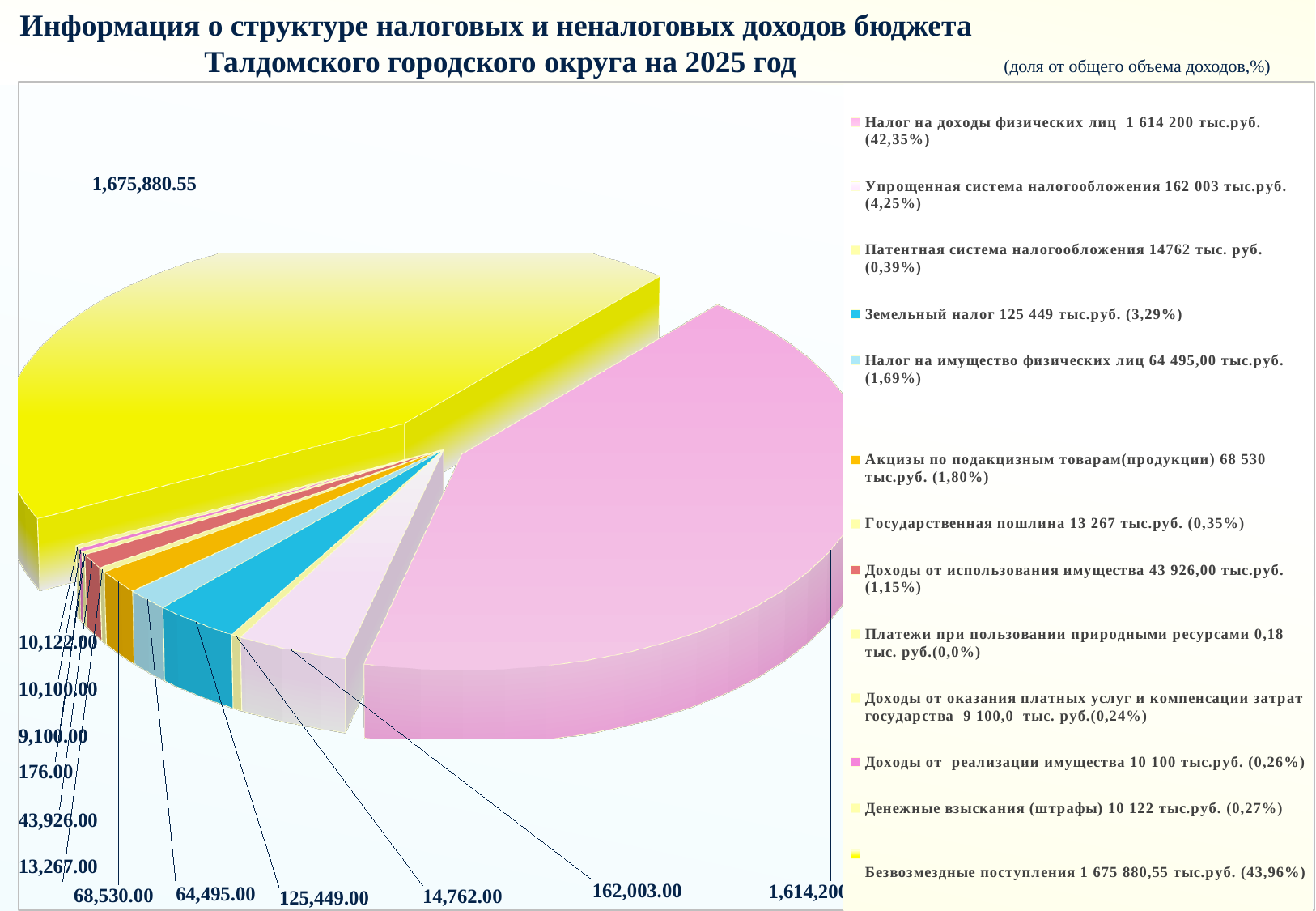
What is the data label value for the Государственная пошлина slice? 13,267.00 What is the data label value for the Безвозмездные поступления slice? 1,675,880.55 Which category has the smallest share of total revenue according to the legend? Платежи при пользовании природными ресурсами Which category has the largest share of total revenue according to the legend? Безвозмездные поступления What share of total revenue does Земельный налог account for, as shown in the legend? 3,29% What share of total revenue does Налог на доходы физических лиц account for, as shown in the legend? 42,35% What kind of chart is shown on the slide? pie chart What is the difference between the data label values for Упрощенная система налогообложения (162,003.00) and Земельный налог (125,449.00)? 36,554.00 For which year does the chart show the structure of budget revenues of Талдомский городской округ? 2025 What is the data label value for the Земельный налог slice? 125,449.00 How many categories does the legend of the pie chart list? 13 Which is larger: the value for Акцизы по подакцизным товарам or the value for Налог на имущество физических лиц? Акцизы по подакцизным товарам